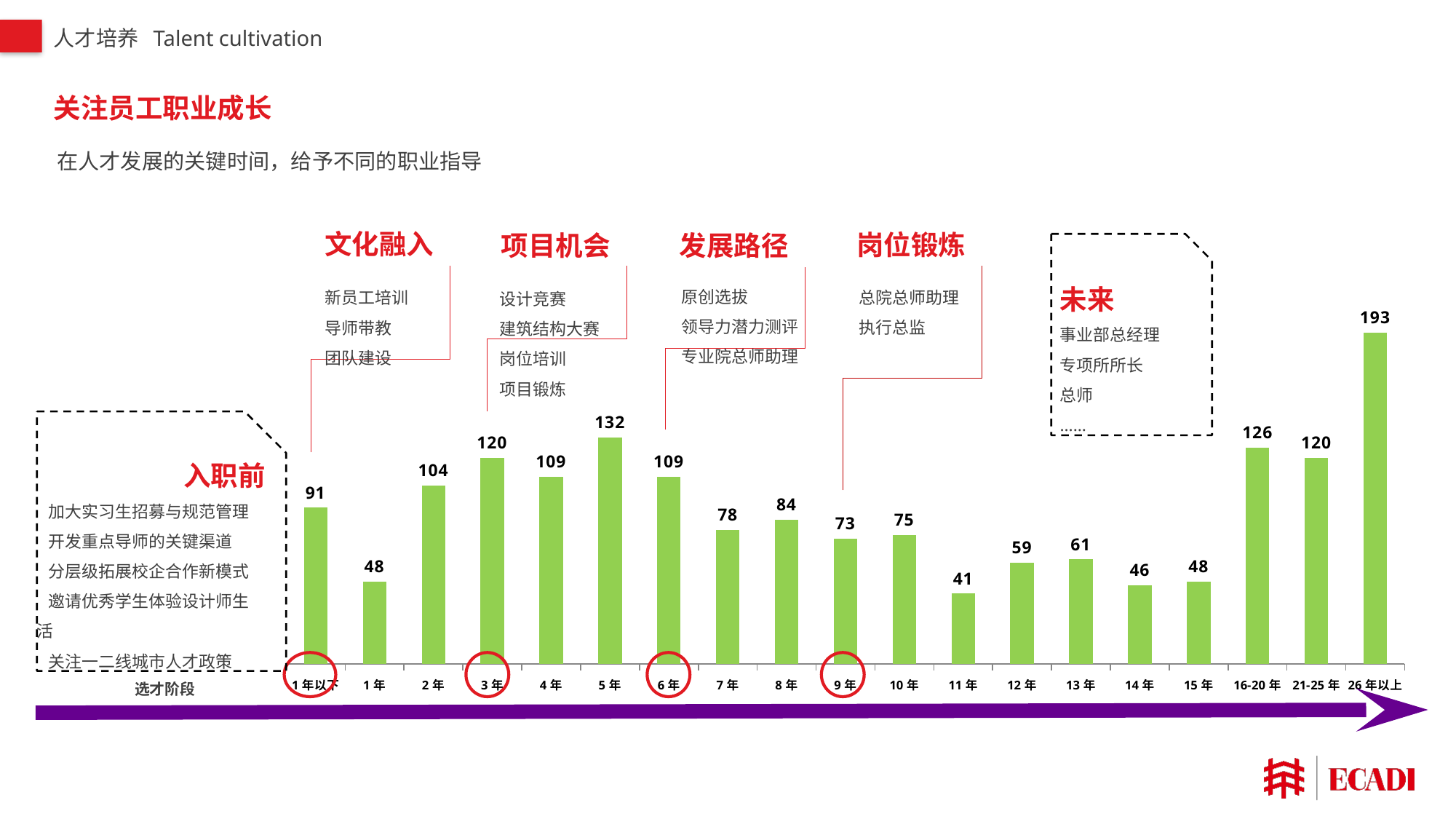
What is the value for the 1 年以下 category? 91 What is the value for the 16-20 年 category? 126 What is the difference between the values for 26 年以上 and 21-25 年? 73 What is the value for the 5 年 category? 132 Which is larger, the value for 12 年 or the value for 14 年? 12 年 Which is larger, the value for 7 年 or the value for 8 年? 8 年 Do the values rise or fall from 5 年 to 11 年? Fall How many categories are shown on the x axis of the chart? 19 What kind of chart is shown on the slide? Bar chart What is the difference between the values for 3 年 and 1 年? 72 Which category has the highest value? 26 年以上 Which category has the lowest value? 11 年